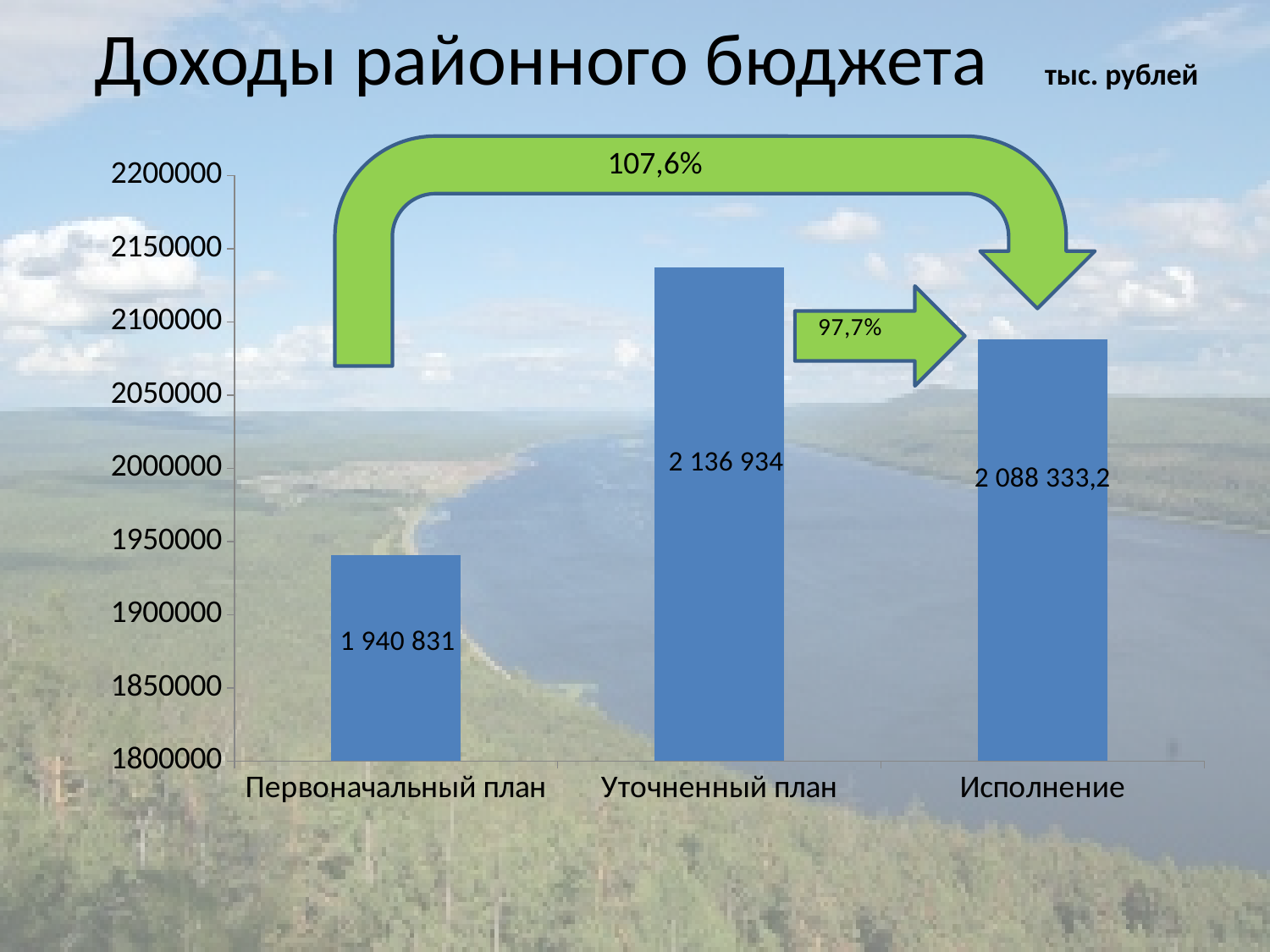
What is the difference between Уточненный план and Исполнение? 48 600,8 What kind of chart is shown on the slide? bar chart How many categories are shown on the x axis? 3 Which is larger, Исполнение or Первоначальный план? Исполнение What is the difference between Уточненный план and Первоначальный план? 196 103 Which category has the lowest value? Первоначальный план What percentage is shown on the arrow from Уточненный план to Исполнение? 97,7% Which category has the highest value? Уточненный план What is the value for Исполнение? 2 088 333,2 Is the value for Первоначальный план greater or less than 2000000? less What is the value for Первоначальный план? 1 940 831 What is the value for Уточненный план? 2 136 934